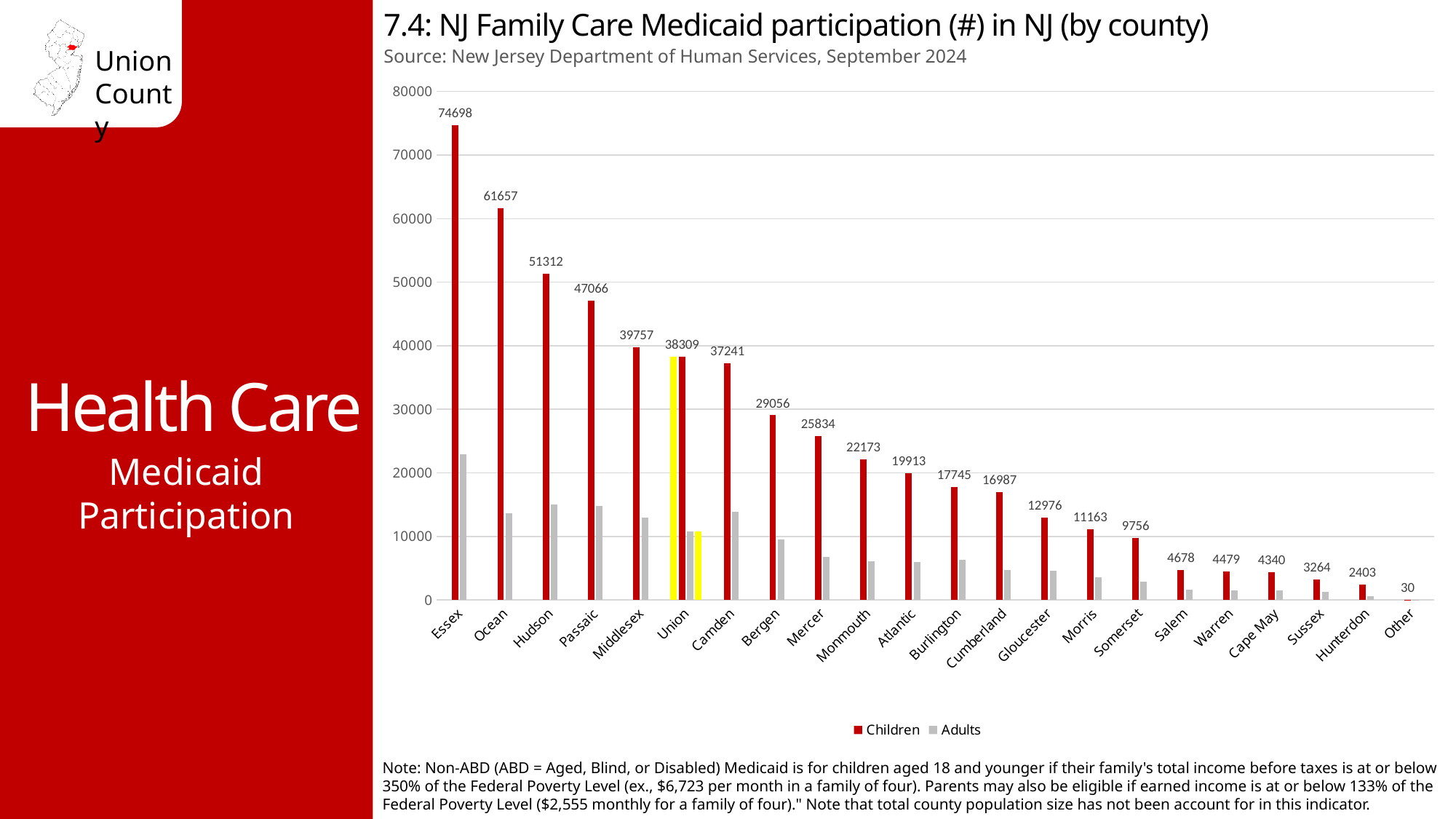
What is the difference between the Children values for Union and Camden? 1068 Which category has the lowest Children value? Other Is the Adults value for Essex greater or less than 20000? greater Is the Adults value for Hudson greater or less than 10000? greater How many series does the legend list? 2 What is the difference between the Children values for Essex and Ocean? 13041 What is the Children value for Union? 38309 Which has a larger Children value, Middlesex or Camden? Middlesex Which category has the highest Children value? Essex How many categories are shown on the x axis? 22 What is the Children value for Somerset? 9756 What is the Children value for Hudson? 51312